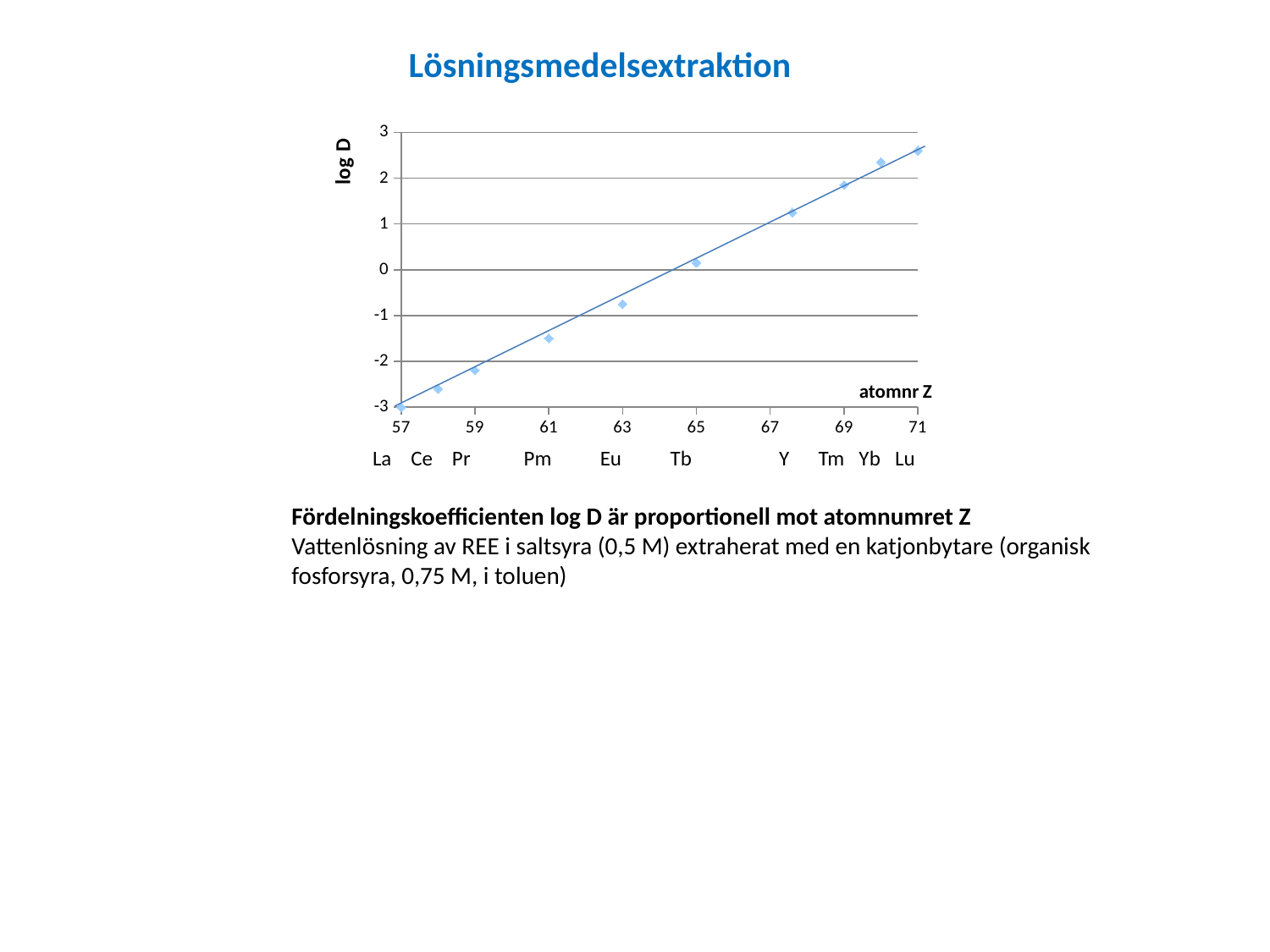
Is the log D value for Ce greater or less than -2? less Which element has the highest log D value? Lu What is the label of the vertical axis? log D How many data points are plotted in the chart? 10 Is the log D value for Lu greater or less than 2? greater Is the log D value for Eu greater or less than 0? less Which element has the lowest log D value? La What kind of chart is shown on the slide? Scatter chart Which has a larger log D value, Eu or Tm? Tm Do the log D values rise or fall as the atomic number Z increases? Rise What is the label of the horizontal axis? atomnr Z